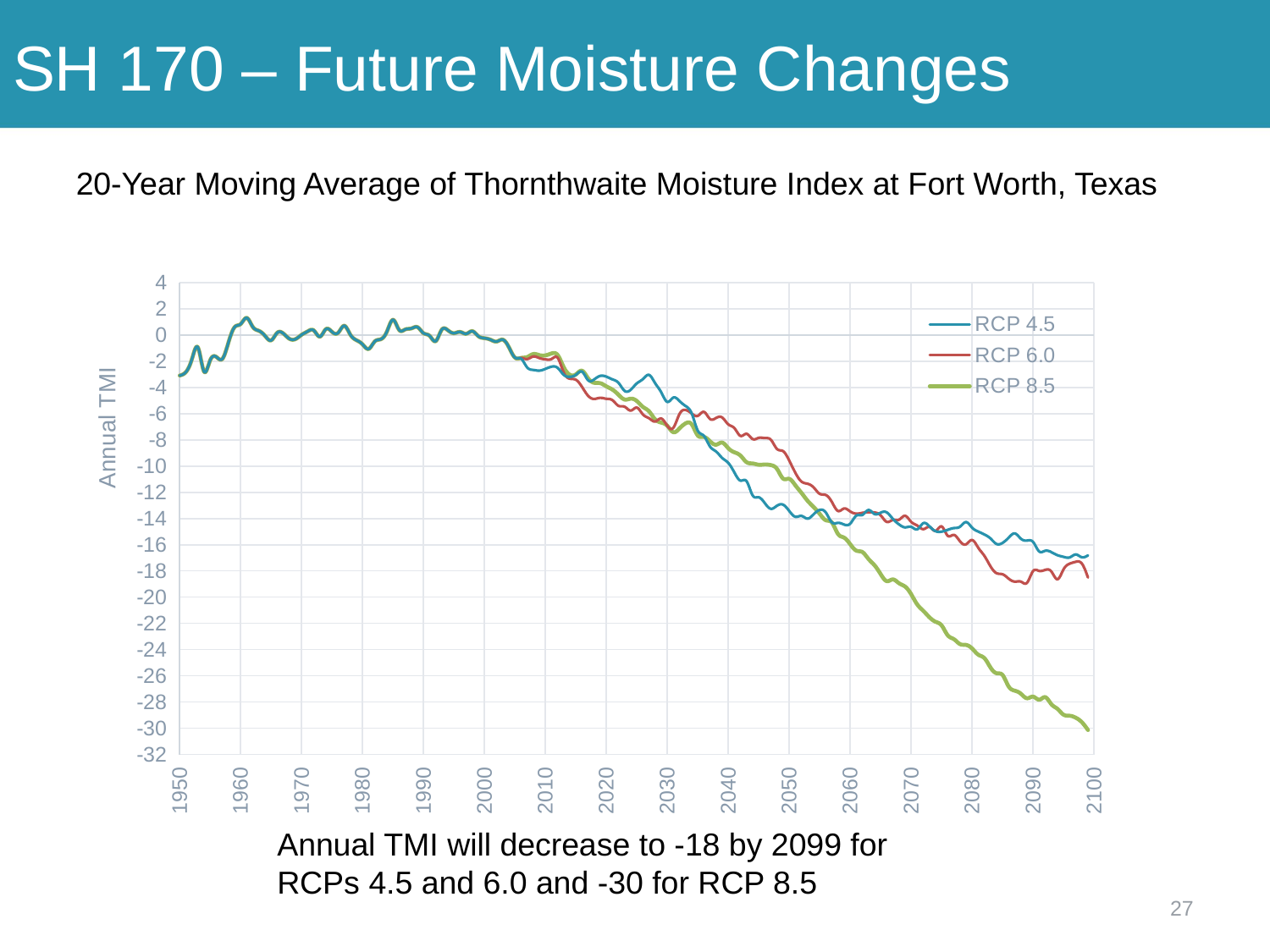
Is the value for RCP 4.5 at 2100 greater or less than -20? greater Which series has the lowest value at 2100? RCP 8.5 What kind of chart is shown on the slide? Line chart At 2100, which series has the larger value, RCP 4.5 or RCP 8.5? RCP 4.5 What is the label on the chart's vertical axis? Annual TMI At 2080, which series has the larger value, RCP 6.0 or RCP 8.5? RCP 6.0 What are the three series named in the chart's legend? RCP 4.5, RCP 6.0, RCP 8.5 Is the value for RCP 4.5 at 2050 greater or less than -10? less Do the values for RCP 8.5 rise or fall along the x axis from 2000 to 2100? Fall Is the value for RCP 8.5 at 2100 greater or less than -28? less How many series does the chart's legend list? 3